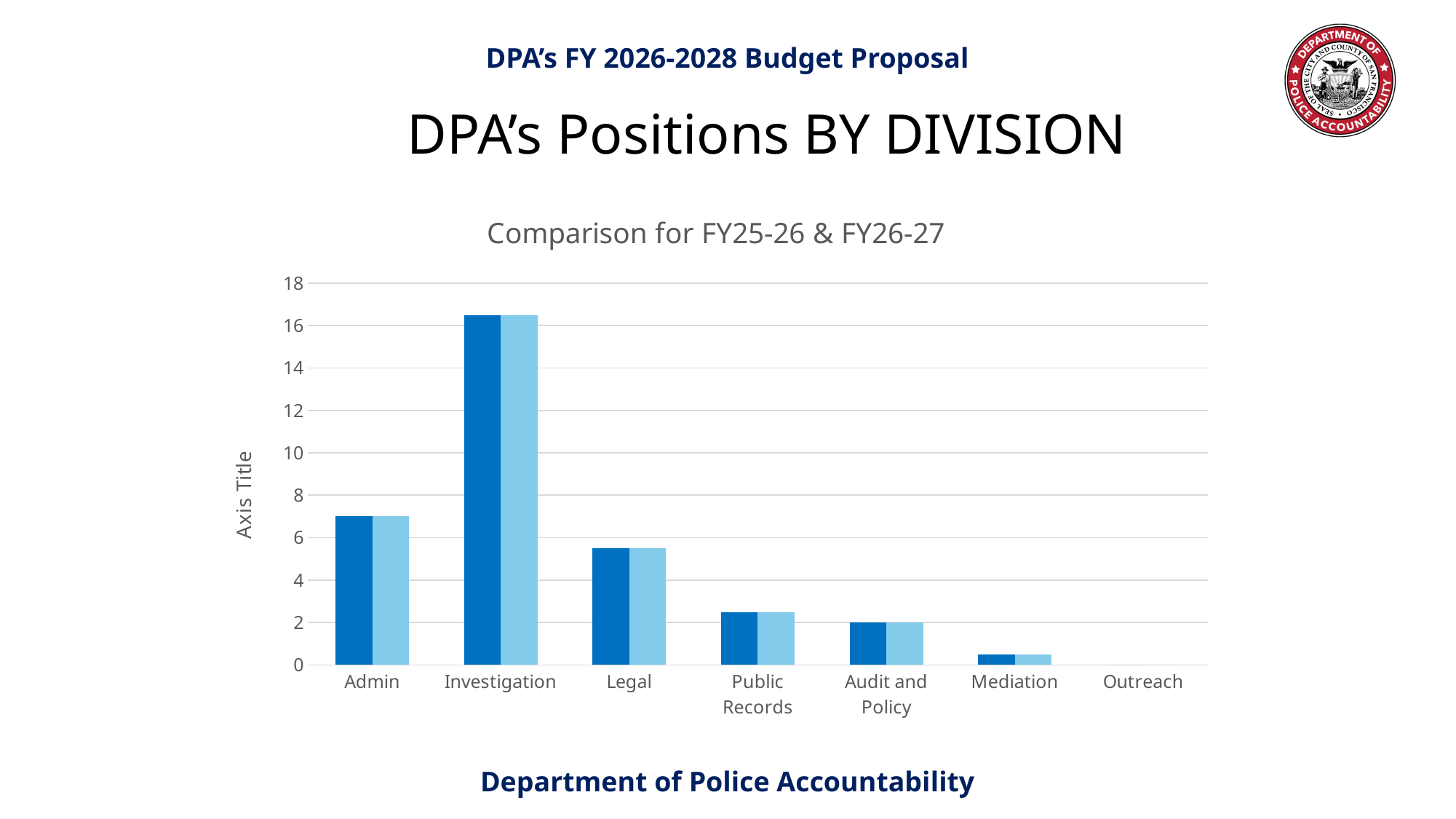
Is the value for Investigation greater or less than 14? greater Which division has the highest number of positions? Investigation What is the title of the chart? Comparison for FY25-26 & FY26-27 What type of chart is shown on the slide? Bar chart Which division has the lowest number of positions? Outreach Is the value for Mediation greater or less than 2? less How many divisions are shown along the x axis of the chart? 7 Which has more positions, Admin or Legal? Admin Is the value for Admin greater or less than 6? greater What is the value for Audit and Policy? 2 What is the value for Outreach? 0